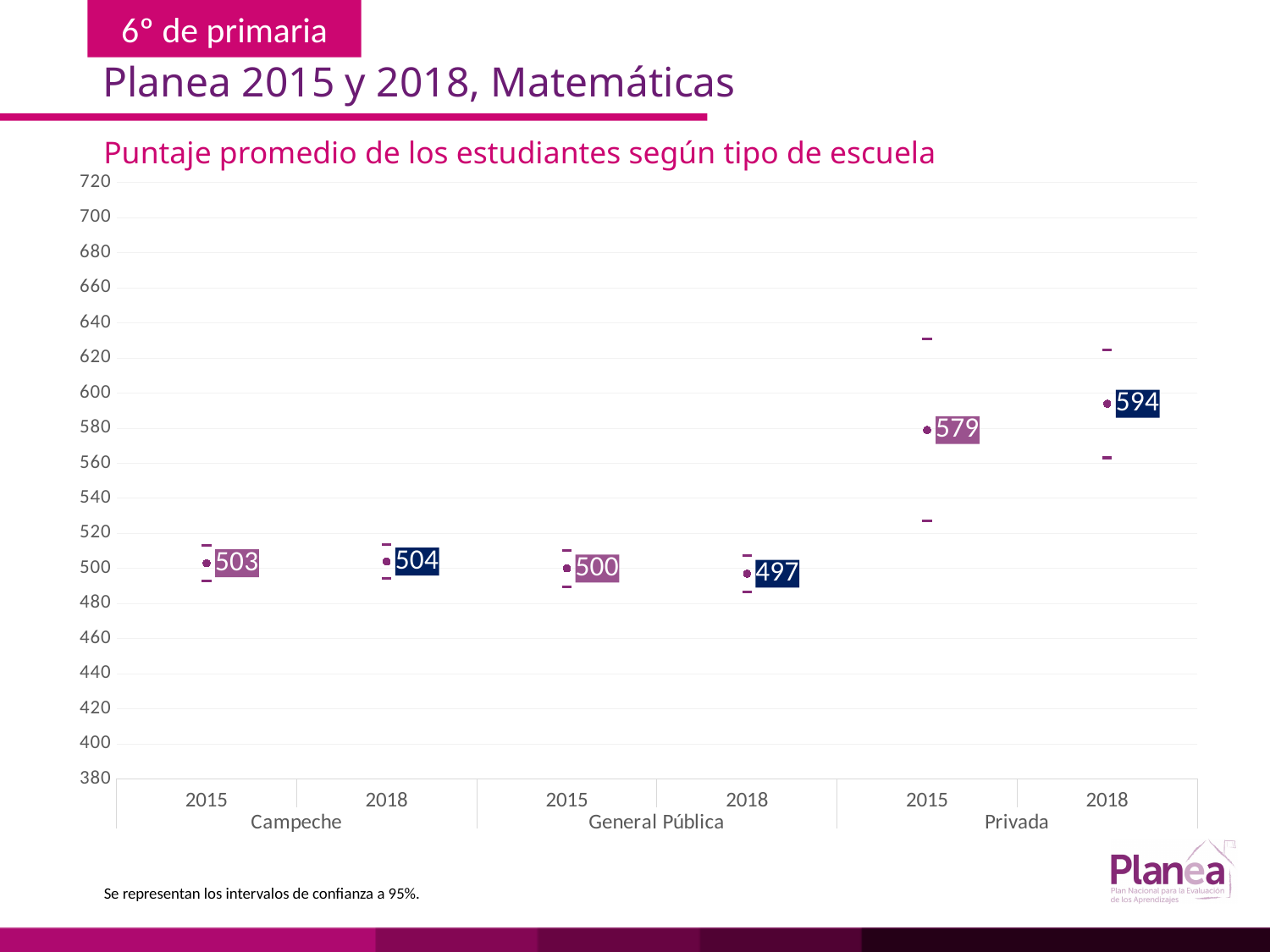
What is the average score for Campeche in 2015? 503 What is the average score for Campeche in 2018? 504 Which group and year has the lowest average score? General Pública 2018 What is the average score for Privada in 2018? 594 What is the difference between the General Pública scores in 2015 and 2018? 3 What is the average score for Privada in 2015? 579 Which is larger, the Privada 2015 score or the Campeche 2018 score? Privada 2015 What is the average score for General Pública in 2018? 497 Which group and year has the highest average score? Privada 2018 How many data points are plotted on the chart? 6 What is the title of the chart? Puntaje promedio de los estudiantes según tipo de escuela What is the difference between the Privada scores in 2018 and 2015? 15